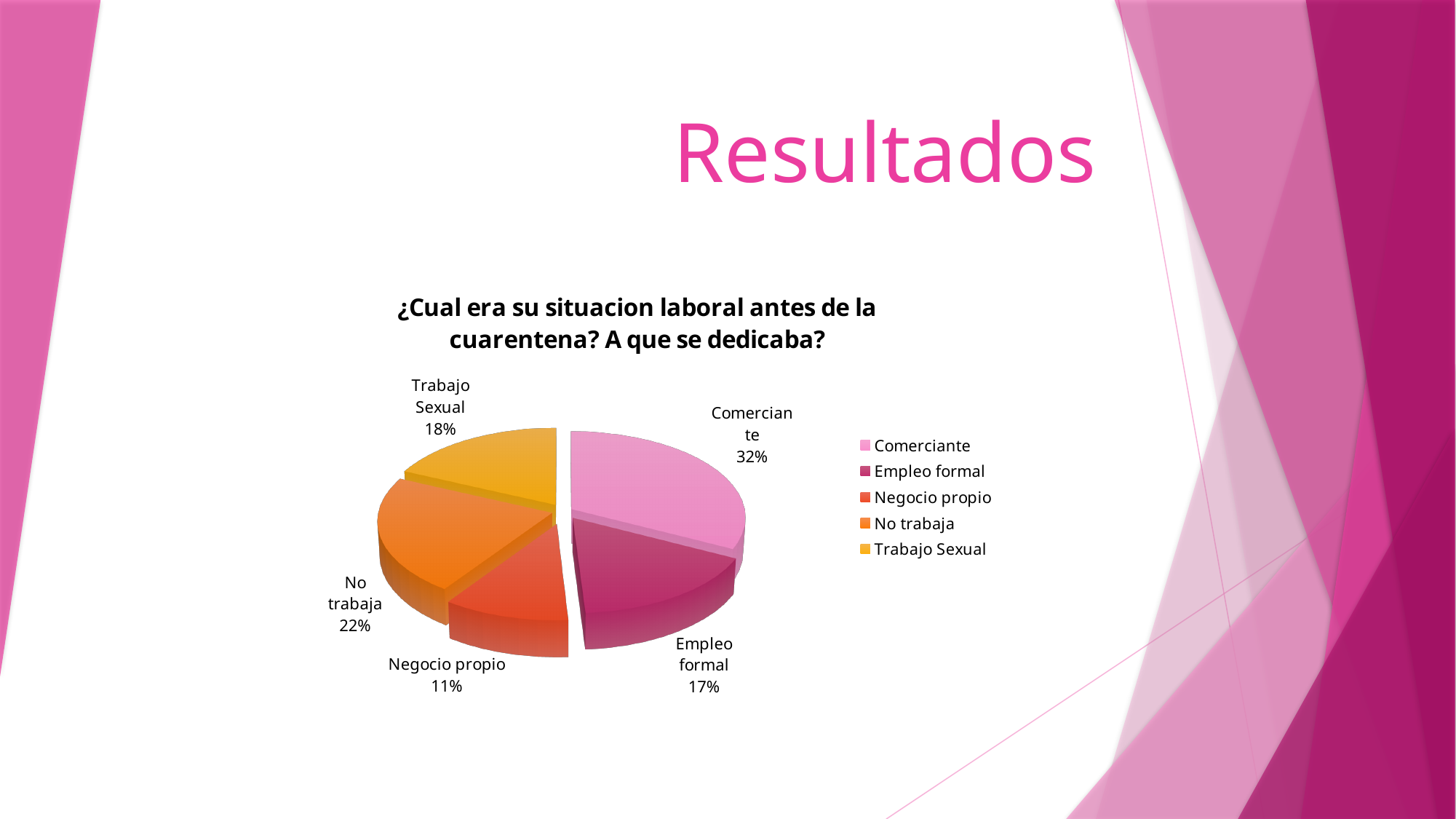
What kind of chart is shown on the slide? Pie chart What is the difference between the No trabaja and Negocio propio shares? 11% What is the value shown for Empleo formal? 17% How many categories are shown in the pie chart? 5 Which is larger, No trabaja or Trabajo Sexual? No trabaja What share of the pie does Comerciante represent? 32% Which category has the smallest slice of the pie? Negocio propio What is the value shown for No trabaja? 22% What is the difference between the Comerciante and Empleo formal shares? 15% What is the title of the chart? ¿Cual era su situacion laboral antes de la cuarentena? A que se dedicaba? Which category has the largest slice of the pie? Comerciante What is the value shown for Trabajo Sexual? 18%